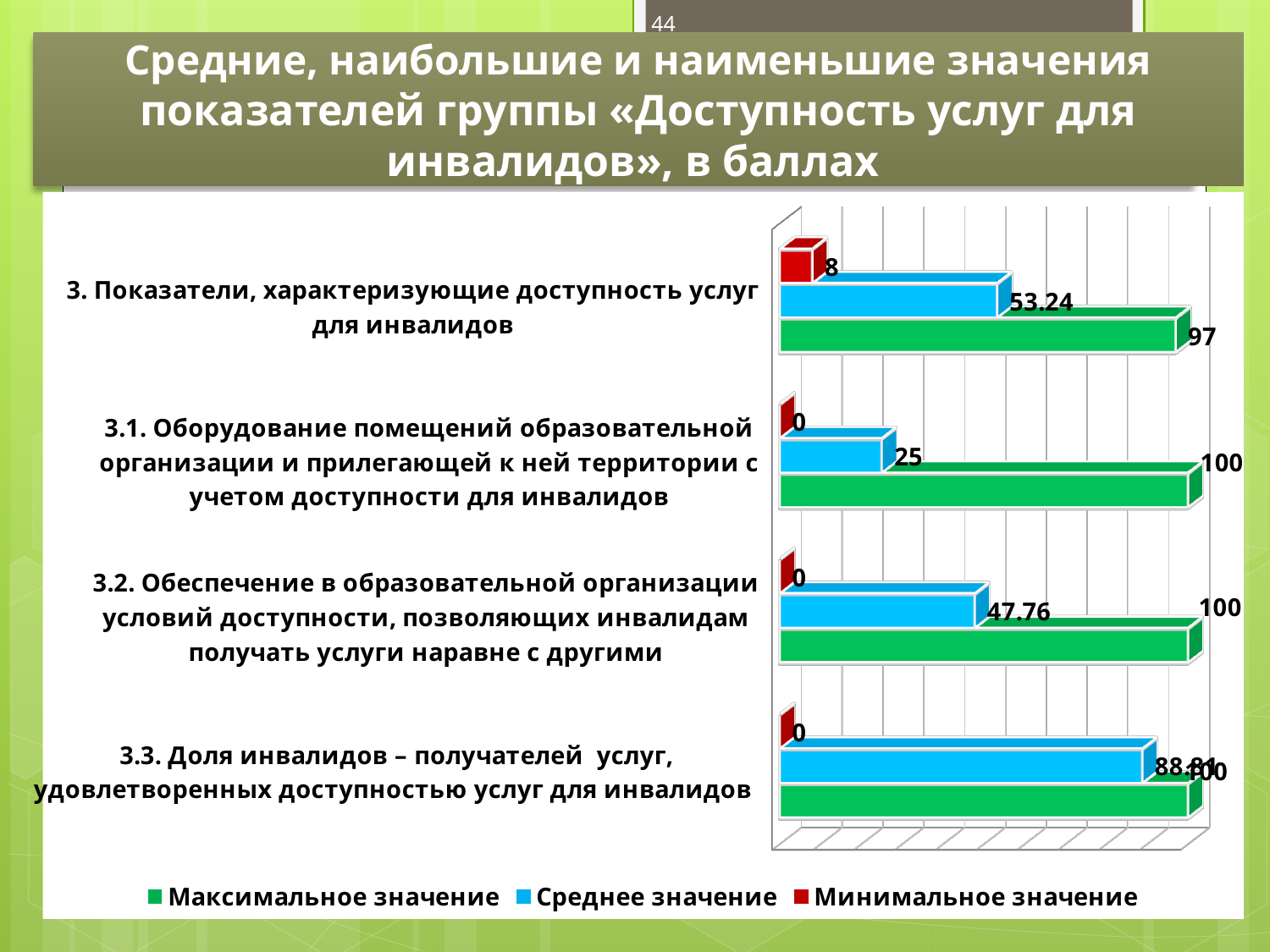
How many categories are plotted on the chart? 4 What is the difference between the Максимальное значение and the Среднее значение for category 3.2? 52.24 How many series does the legend list? 3 What is the Минимальное значение for category 3.3 (Доля инвалидов – получателей услуг)? 0 Which category has the lowest Среднее значение? 3.1. Оборудование помещений образовательной организации и прилегающей к ней территории с учетом доступности для инвалидов What is the Минимальное значение for category 3 (Показатели, характеризующие доступность услуг для инвалидов)? 8 What is the Среднее значение for category 3 (Показатели, характеризующие доступность услуг для инвалидов)? 53.24 What kind of chart is shown on the slide? bar chart What is the Среднее значение for category 3.2 (Обеспечение в образовательной организации условий доступности)? 47.76 What is the Среднее значение for category 3.1 (Оборудование помещений образовательной организации)? 25 Which series is shown in green in the legend? Максимальное значение What is the Максимальное значение for category 3 (Показатели, характеризующие доступность услуг для инвалидов)? 97